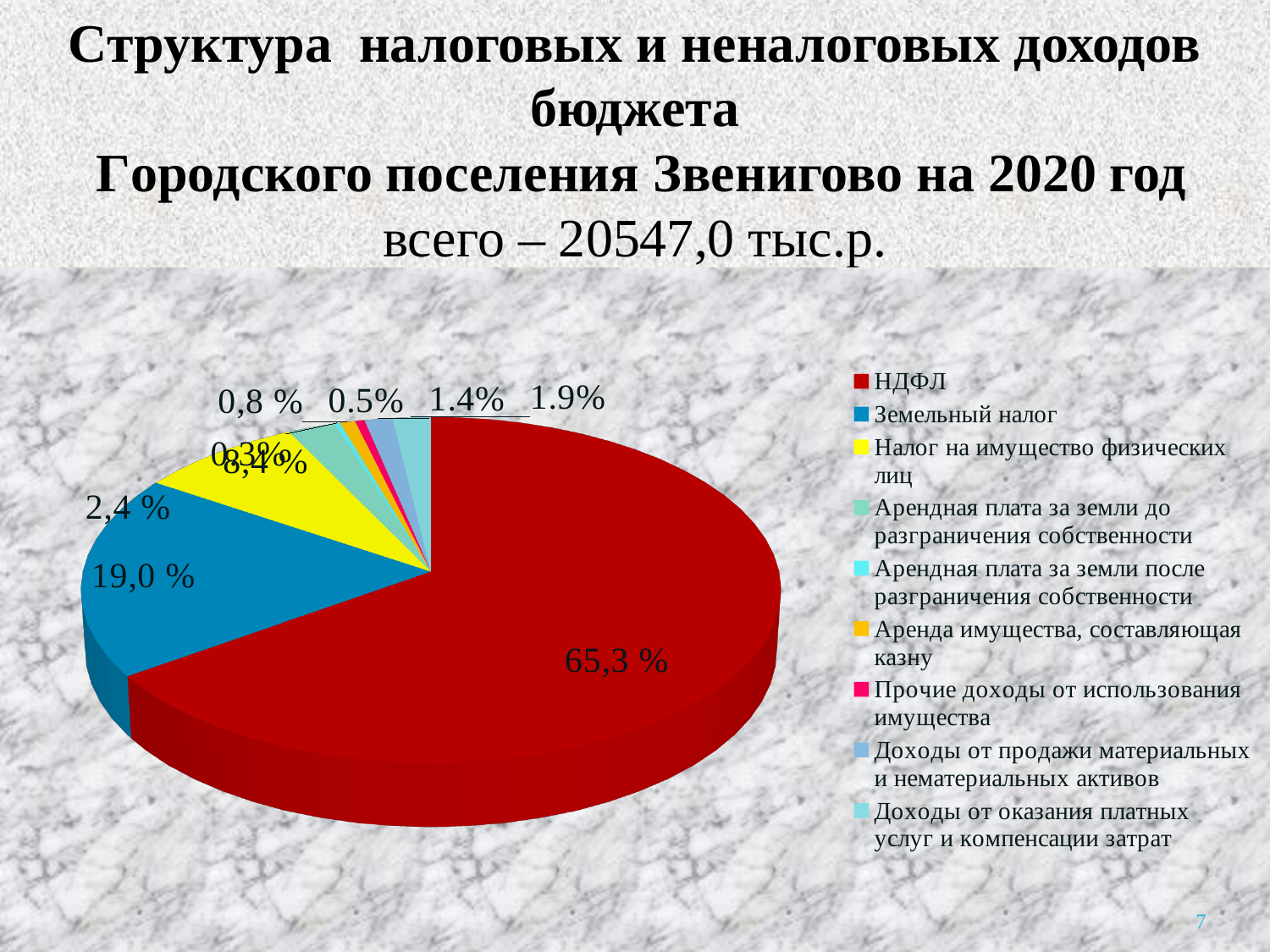
What colour is the slice for НДФЛ? red What is the difference in percentage points between the share of НДФЛ and the share of Земельный налог? 46,3 Which is larger, the share of НДФЛ or the share of Земельный налог? НДФЛ What total amount of revenues is stated in the slide title? 20547,0 тыс.р. What share does Налог на имущество физических лиц account for? 8,4 % Which is larger, the share of Земельный налог or the share of Налог на имущество физических лиц? Земельный налог How many categories does the legend list? 9 What share of the budget revenues does НДФЛ account for? 65,3 % What kind of chart is shown on the slide? pie chart What share does Земельный налог account for? 19,0 % What is the difference in percentage points between the share of Земельный налог and the share of Налог на имущество физических лиц? 10,6 Which category has the largest share of the pie? НДФЛ